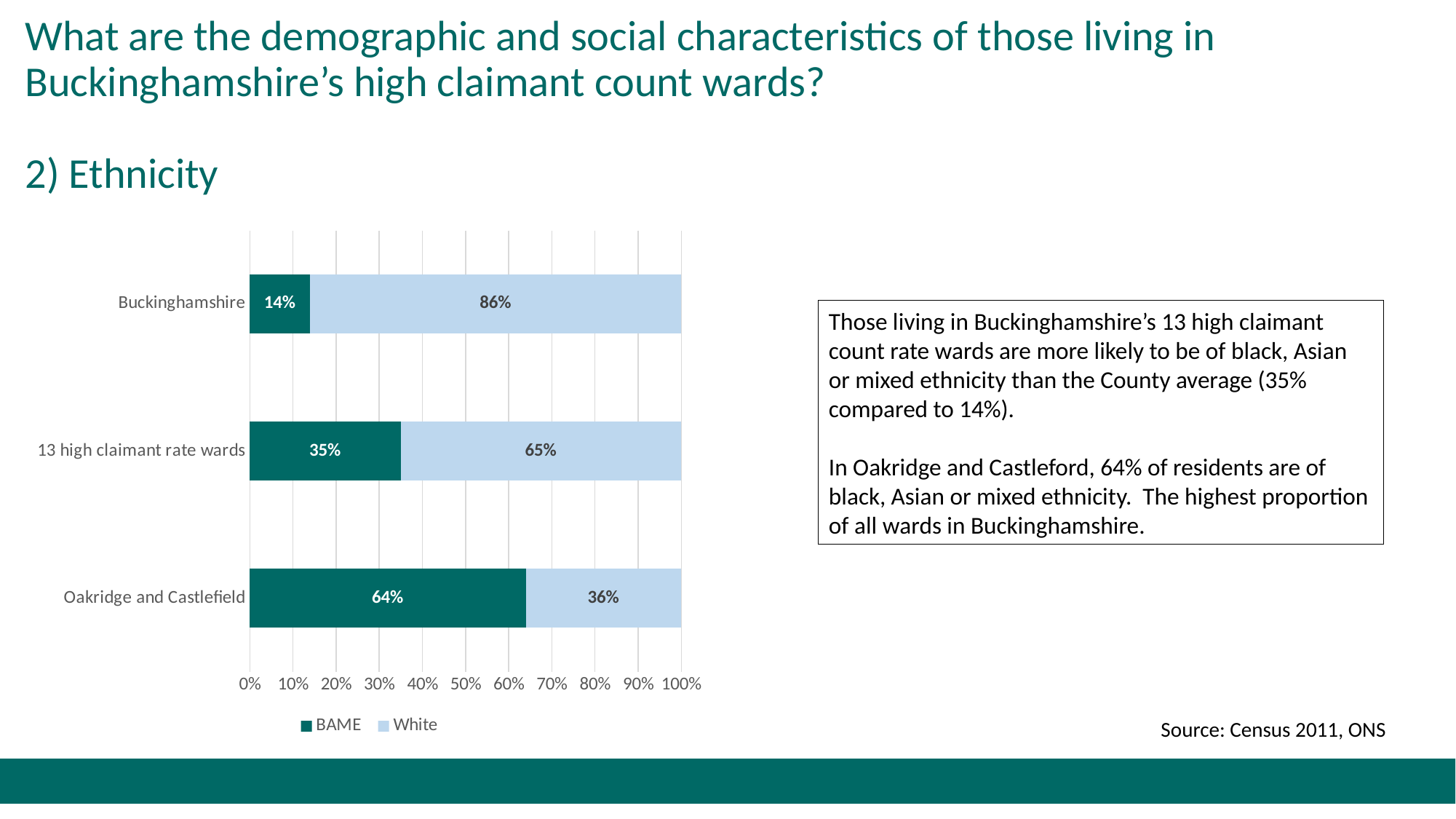
How many categories are shown on the chart? 3 What is the White value for Buckinghamshire? 86% What is the White value for the 13 high claimant rate wards? 65% What is the difference between the BAME value for the 13 high claimant rate wards and the BAME value for Buckinghamshire? 21% What kind of chart is shown on the slide? Stacked bar chart What is the BAME value for Buckinghamshire? 14% What is the BAME value for Oakridge and Castlefield? 64% Which category has the highest BAME value? Oakridge and Castlefield What is the total of the stacked bar for the 13 high claimant rate wards? 100% How many series does the legend list? 2 Which category has the lowest White value? Oakridge and Castlefield Which is larger: the BAME value for Oakridge and Castlefield or the White value for Oakridge and Castlefield? BAME